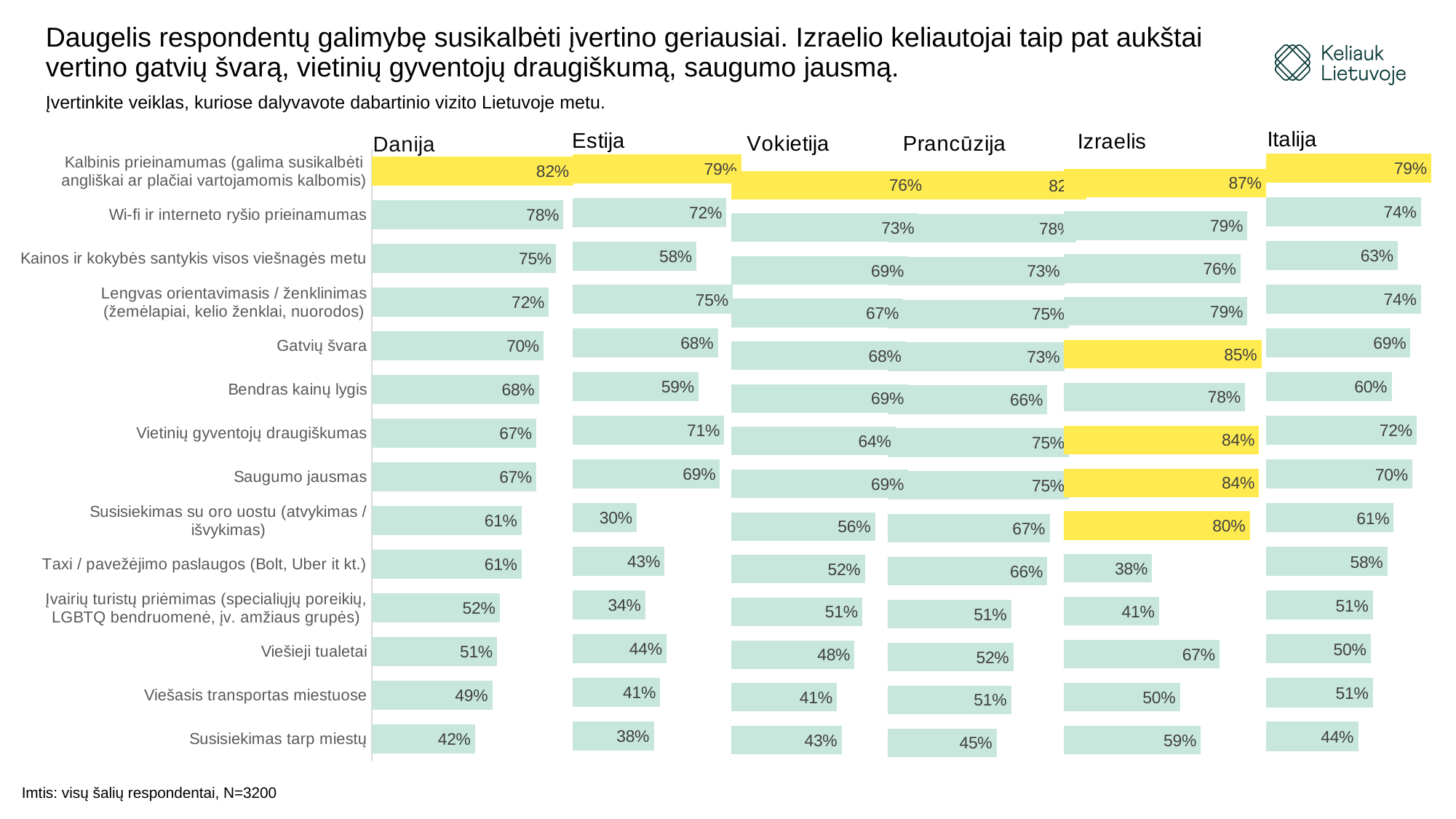
In the Estija chart, which category has the lowest value? Susisiekimas su oro uostu (atvykimas / išvykimas) How many categories are shown in the Danija chart? 14 In the Izraelis chart, what is the value for Gatvių švara? 85% What type of chart is used on this slide? Bar chart How many country charts are shown on the slide? 6 In the Danija chart, what is the value for Wi-fi ir interneto ryšio prieinamumas? 78% In the Izraelis chart, what colour are the bars for Gatvių švara, Vietinių gyventojų draugiškumas and Saugumo jausmas? Yellow In the Vokietija chart, what is the difference between Kalbinis prieinamumas (76%) and Susisiekimas tarp miestų (43%)? 33 percentage points In the Izraelis chart, which category has the highest value? Kalbinis prieinamumas (galima susikalbėti angliškai ar plačiai vartojamomis kalbomis) In the Estija chart, what is the value for Susisiekimas su oro uostu (atvykimas / išvykimas)? 30% For Taxi / pavežėjimo paslaugos (Bolt, Uber it kt.), which is higher: the Danija chart or the Izraelis chart? Danija In the Italija chart, what is the value for Kainos ir kokybės santykis visos viešnagės metu? 63%